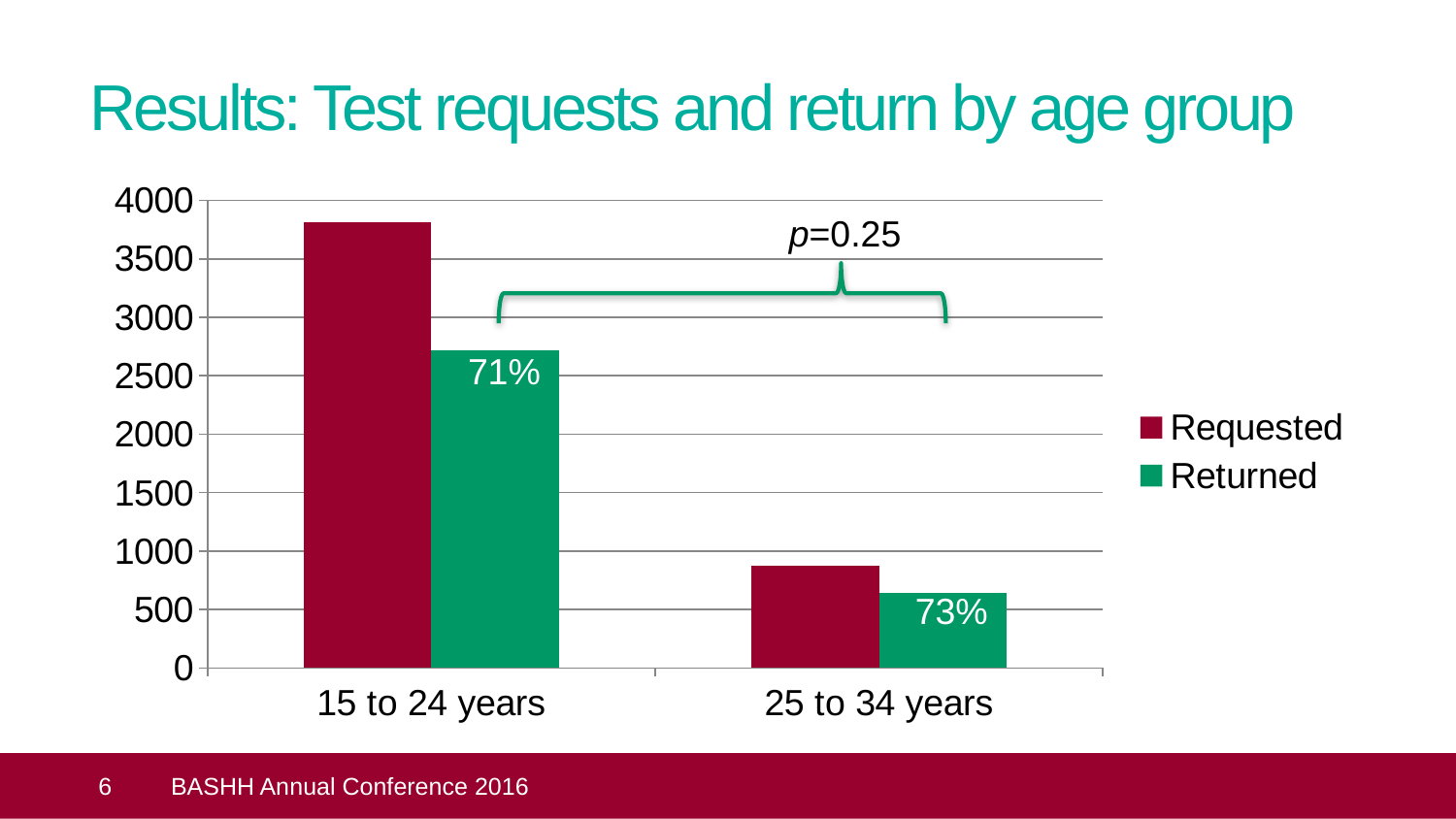
What percentage label is printed on the Returned bar for 15 to 24 years? 71% What percentage label is printed on the Returned bar for 25 to 34 years? 73% Which age group has the highest Requested value? 15 to 24 years Is the Requested value for 25 to 34 years greater or less than 1000? less How many series does the legend list? 2 Is the Requested value for 15 to 24 years greater or less than 3500? greater What p-value is annotated above the chart? p=0.25 What kind of chart is shown on the slide? bar chart Is the Returned value for 15 to 24 years greater or less than 3000? less Which age group has the lowest Returned value? 25 to 34 years For 15 to 24 years, which is larger: Requested or Returned? Requested How many age groups are shown on the x axis? 2